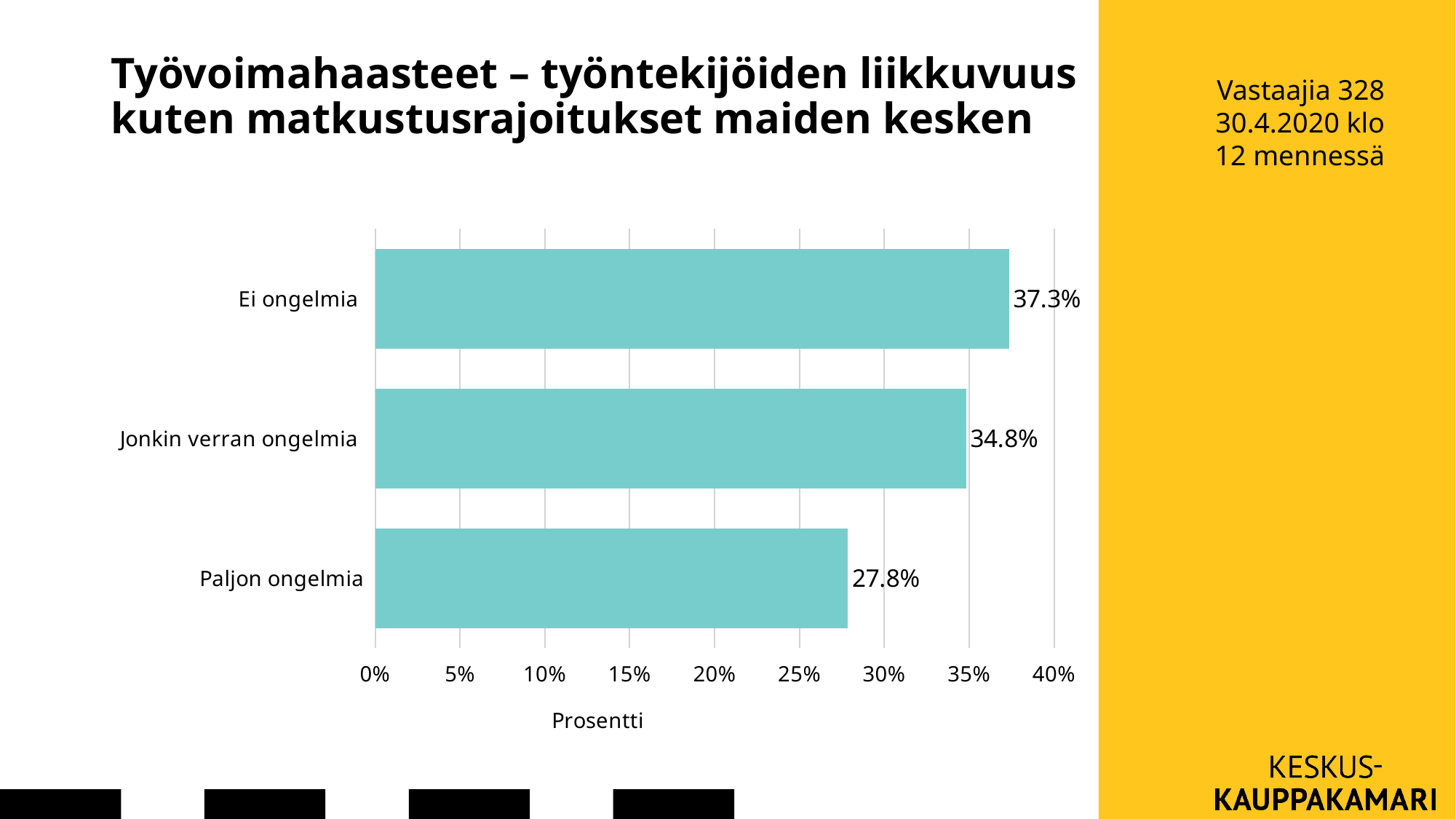
What is the value for Paljon ongelmia? 27.8% What is the difference between the values for Ei ongelmia and Jonkin verran ongelmia? 2.5% What is the difference between the values for Ei ongelmia and Paljon ongelmia? 9.5% What kind of chart is shown on the slide? bar chart What is the value for Ei ongelmia? 37.3% What is the value for Jonkin verran ongelmia? 34.8% Which category has the lowest value? Paljon ongelmia What is the label of the horizontal axis? Prosentti Which is larger, the value for Jonkin verran ongelmia or the value for Paljon ongelmia? Jonkin verran ongelmia Is the value for Paljon ongelmia greater or less than 30%? less Which category has the highest value? Ei ongelmia How many categories are shown in the chart? 3